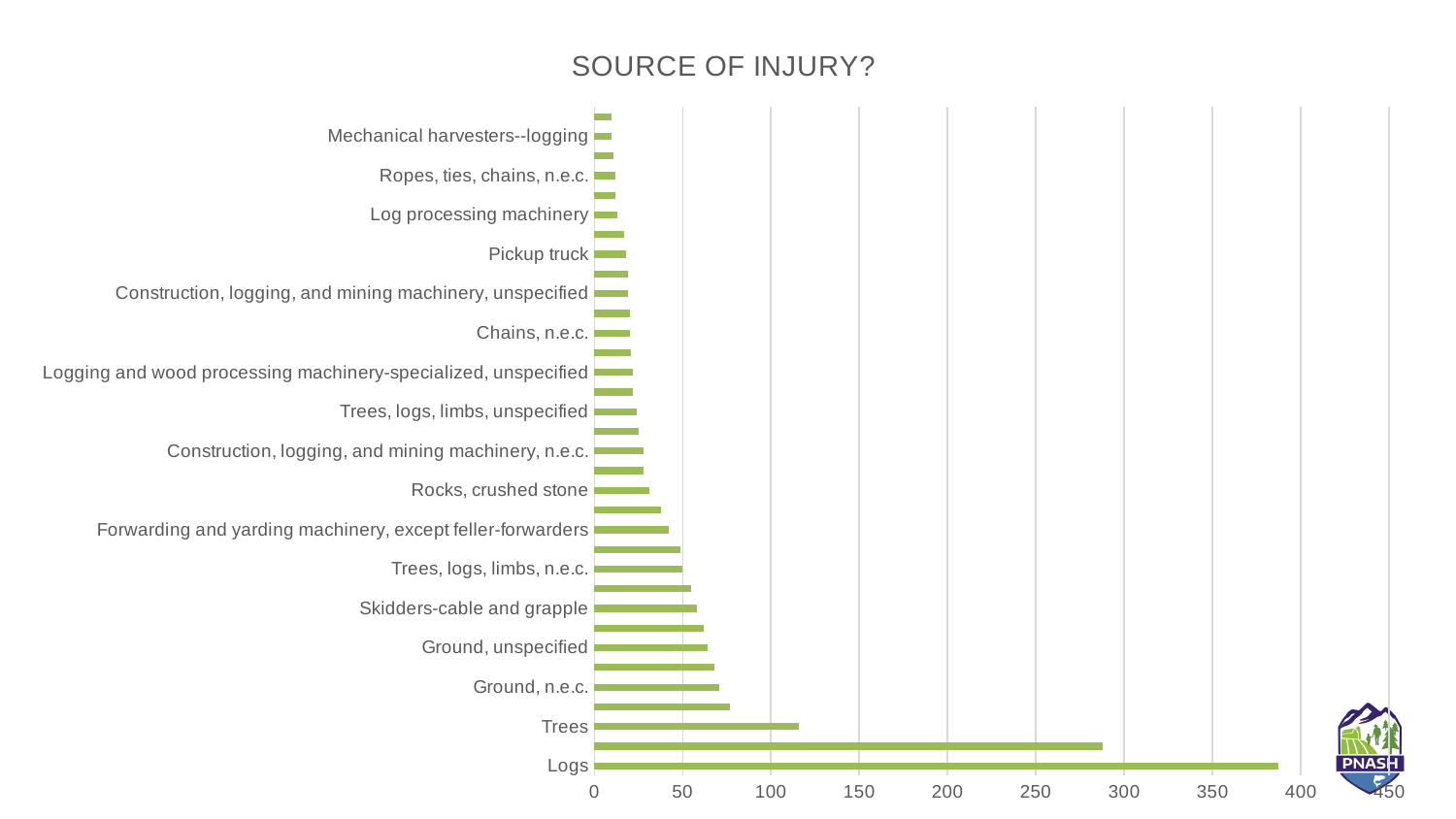
Which labeled source of injury has the lowest value? Mechanical harvesters--logging What kind of chart is shown on the slide? bar chart Is the value for Rocks, crushed stone greater or less than 50? less Which source of injury has the highest value? Logs Is the value for Trees greater or less than 100? greater Do the bar values increase or decrease going from the top of the chart to the bottom? increase Is the value for Logs greater or less than 350? greater What is the highest value shown on the horizontal axis? 450 Which has a larger value, Logs or Trees? Logs What is the title of the chart? SOURCE OF INJURY? Which has a larger value, Pickup truck or Rocks, crushed stone? Rocks, crushed stone